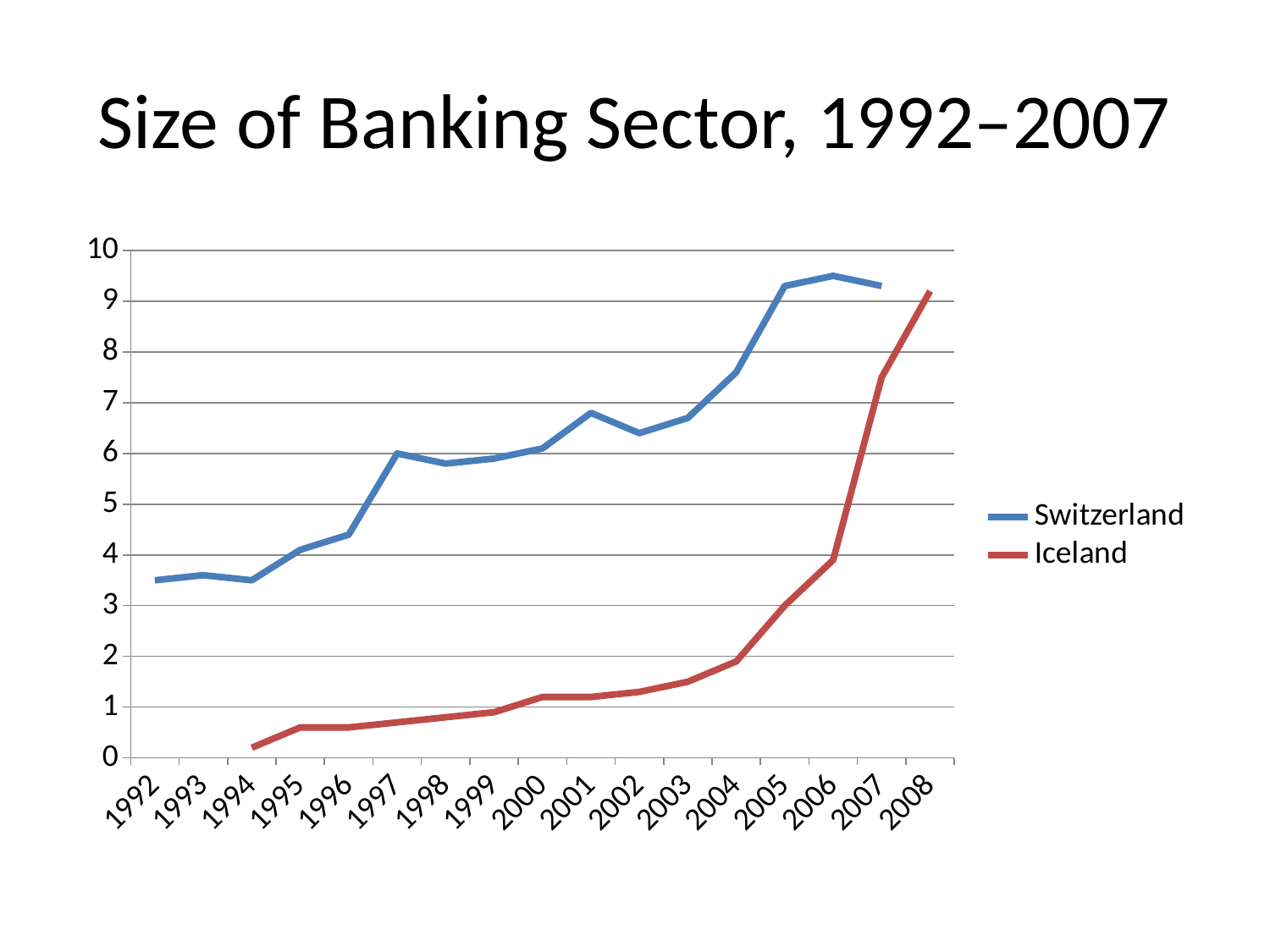
In which year does the Iceland line have its lowest value? 1994 Is the value for Iceland in 2004 greater or less than 3? less Is the value for Switzerland in 2005 greater or less than 9? greater Is the value for Iceland in 2007 greater or less than 7? greater Does the Iceland line generally rise or fall from 1994 to 2008? rise In which year does the Switzerland line reach its highest value? 2006 How many series does the legend list? 2 Which series has the larger value in 2000, Switzerland or Iceland? Switzerland How many years are labelled on the x axis? 17 What kind of chart is shown on the slide? line chart